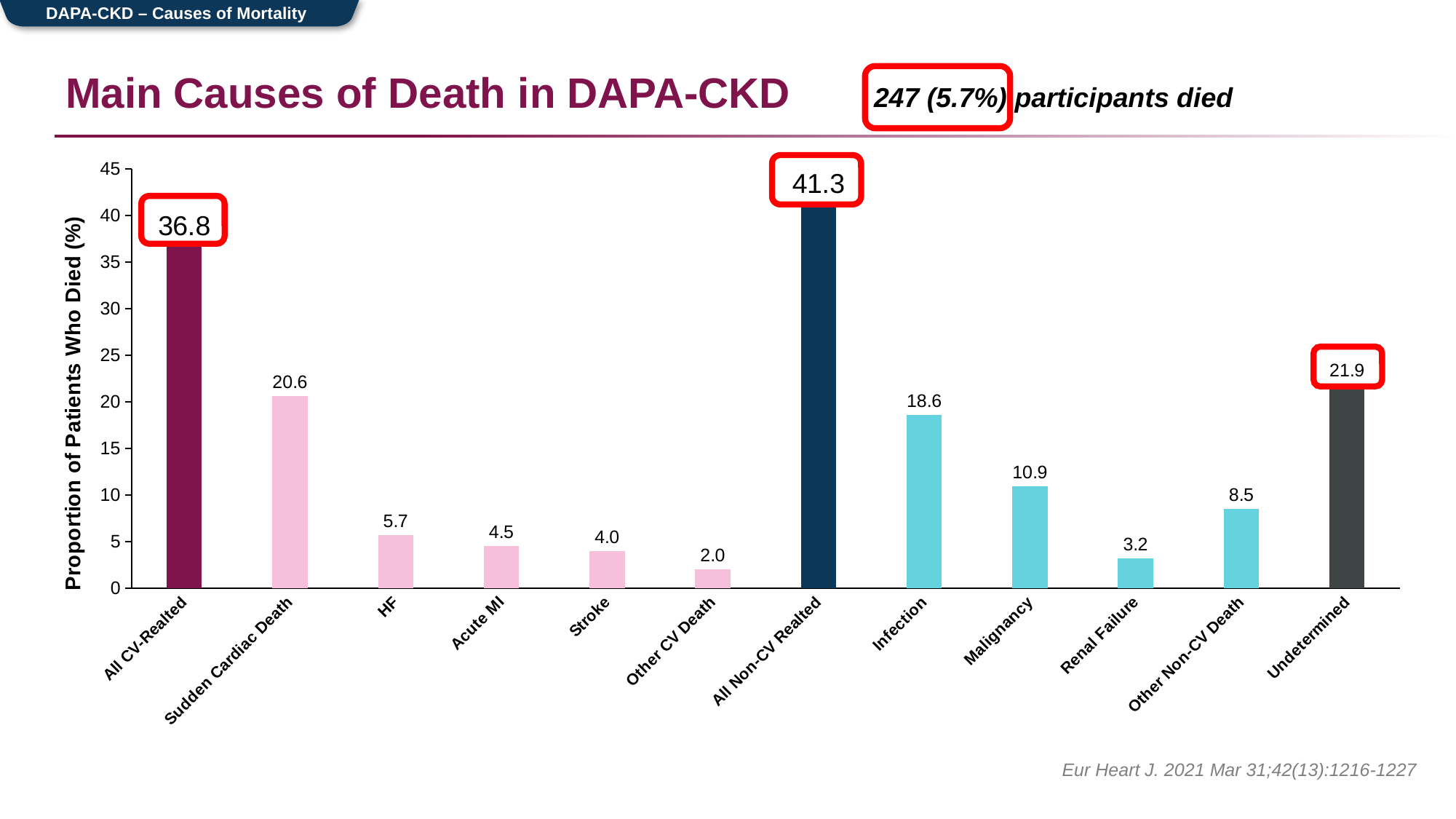
What kind of chart is shown on the slide? bar chart Is the value for Infection greater or less than 15? greater Which is larger, the value for Malignancy or the value for Other Non-CV Death? Malignancy What is the value for Sudden Cardiac Death? 20.6 What is the value for Undetermined? 21.9 Which category has the highest value? All Non-CV Realted What is the value for Infection? 18.6 What is the difference between the values for All Non-CV Realted and All CV-Realted? 4.5 How many categories are shown on the x axis? 12 What is the y-axis label of the chart? Proportion of Patients Who Died (%) What is the difference between the values for HF and Stroke? 1.7 Which category has the lowest value? Other CV Death